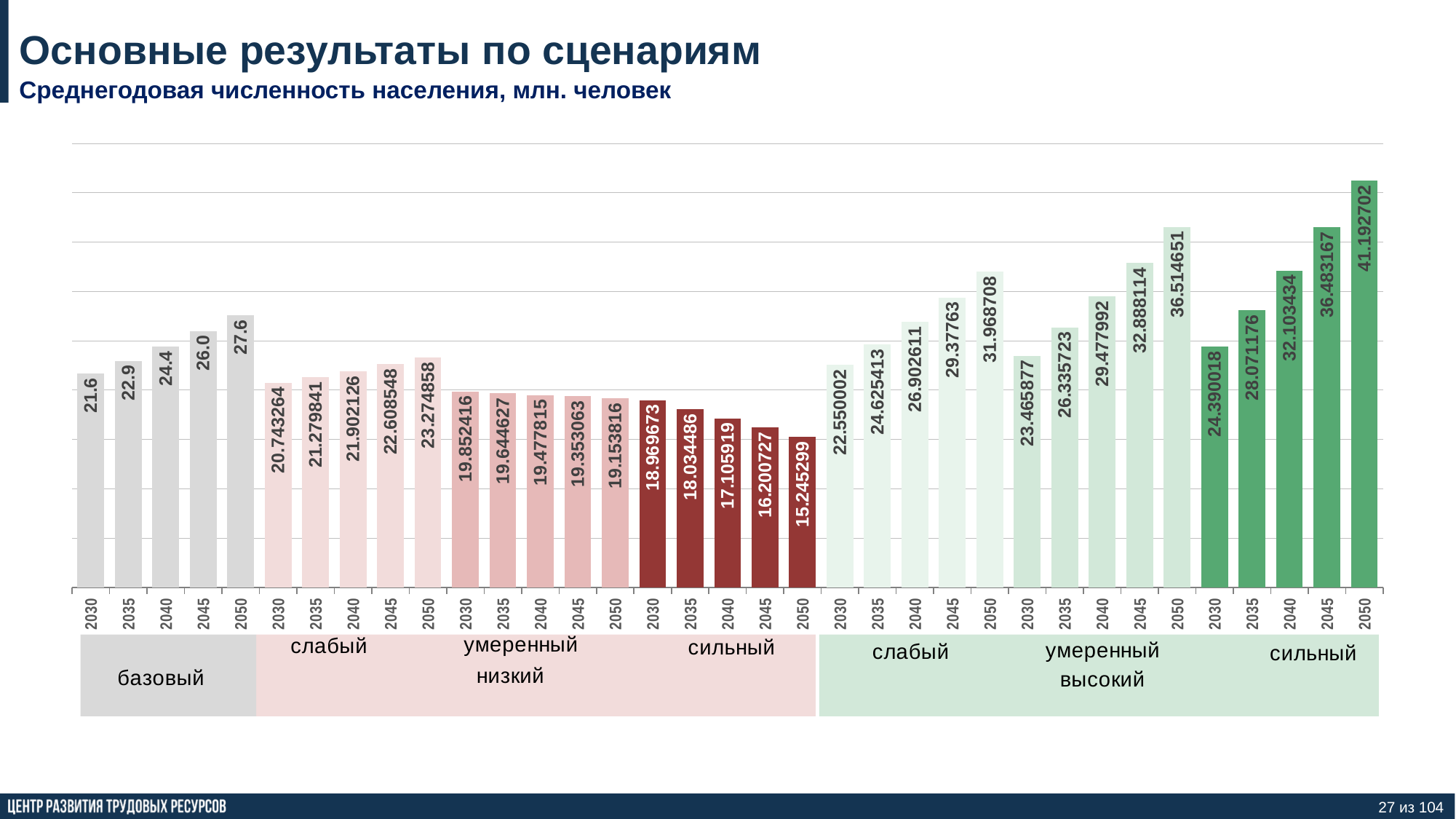
Which is larger: the 2050 value in the слабый высокий scenario or the 2050 value in the умеренный высокий scenario? умеренный высокий (36.514651) How many bars are plotted on the chart in total? 35 Which bar on the chart has the highest value? 2050, сильный высокий (41.192702) What is the value for 2030 in the сильный variant of the низкий scenario? 18.969673 What type of chart is shown on the slide? bar chart What is the value for 2050 in the базовый scenario? 27.6 Which bar on the chart has the lowest value? 2050, сильный низкий (15.245299) What is the value for 2050 in the сильный variant of the высокий scenario? 41.192702 Do the values rise or fall from 2030 to 2050 in the сильный variant of the низкий scenario? fall Do the values rise or fall from 2030 to 2050 in the слабый variant of the высокий scenario? rise What is the value for 2040 in the умеренный variant of the высокий scenario? 29.477992 What is the difference between the 2050 and 2030 values in the базовый scenario? 6.0